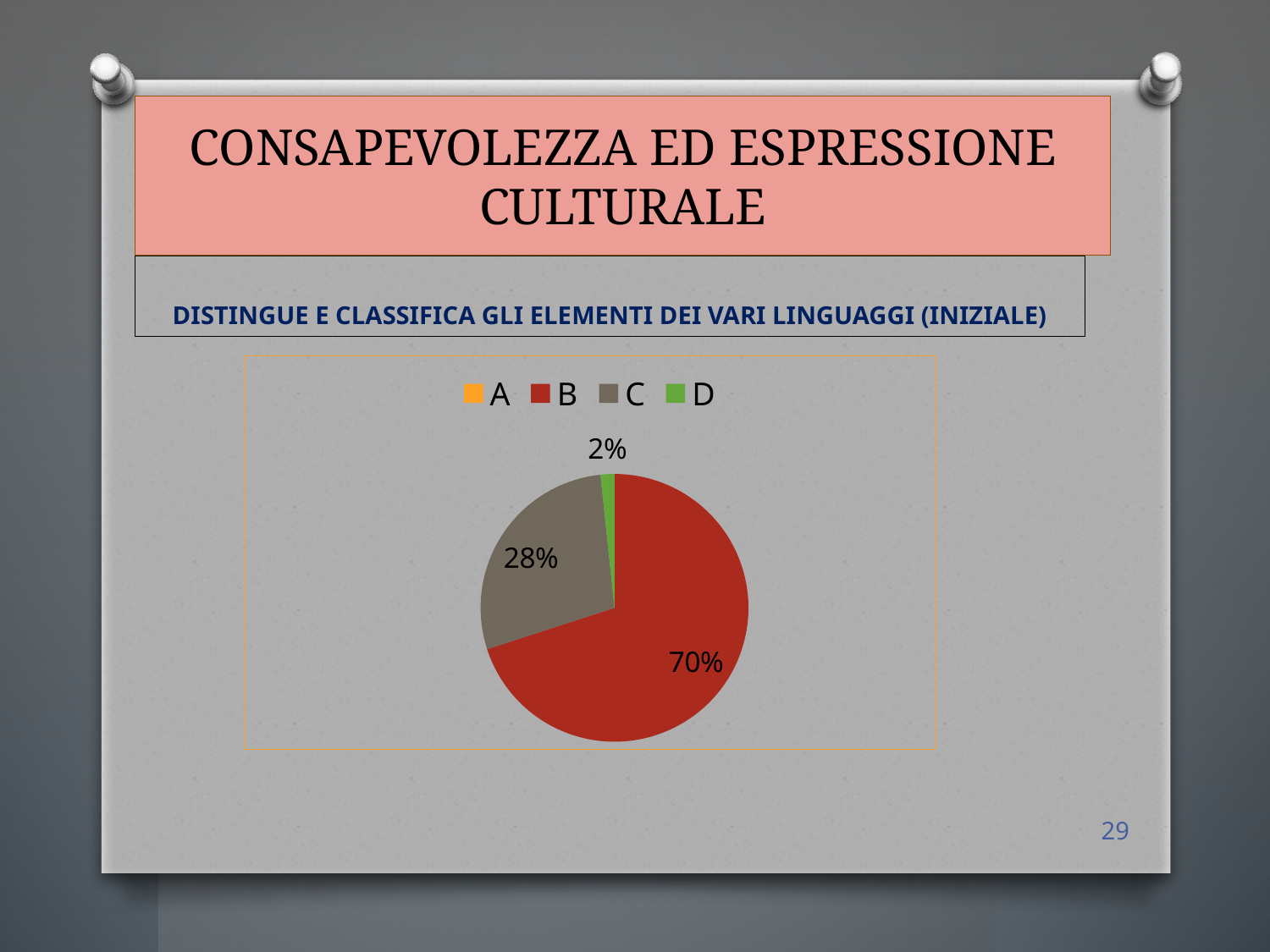
What is the difference in percentage points between category B and category C? 42 percentage points What kind of chart is shown on the slide? pie chart What is the combined share of categories C and D? 30% What colour is the slice for category B? red Which category has the largest slice of the pie? B Which is larger, the slice for C or the slice for D? C How many entries does the legend list? 4 What is the text shown above the chart describing the competence being measured? DISTINGUE E CLASSIFICA GLI ELEMENTI DEI VARI LINGUAGGI (INIZIALE) Which of the labelled slices is the smallest? D What percentage of the pie does category B represent? 70% What percentage of the pie does category C represent? 28% What percentage of the pie does category D represent? 2%